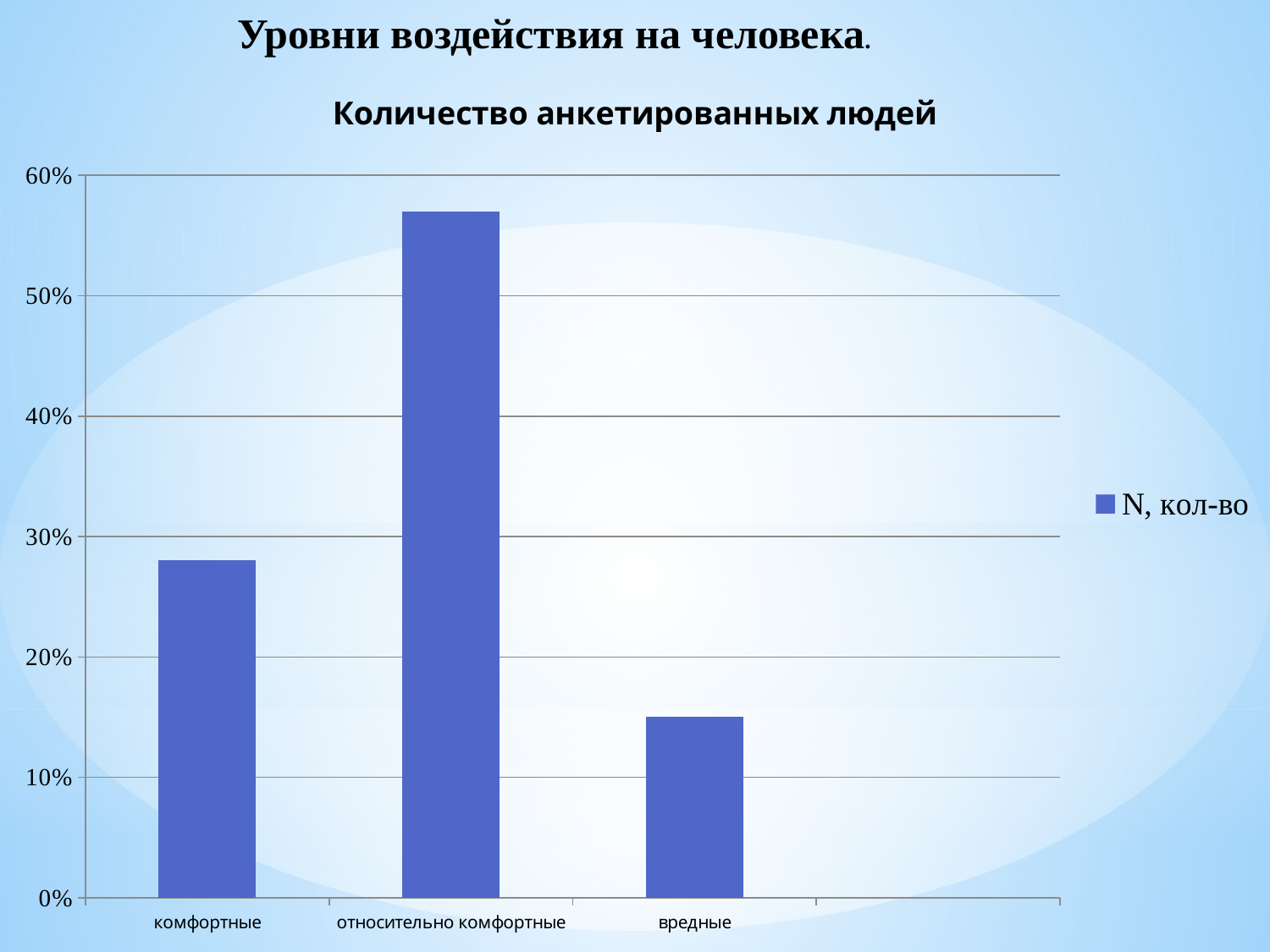
Is the value for комфортные greater or less than 30%? less Which category has the lowest bar? вредные Is the value for комфортные greater or less than 20%? greater Which is larger, the value for комфортные or the value for вредные? комфортные What is the title of the chart? Количество анкетированных людей Which is larger, the value for относительно комфортные or the value for комфортные? относительно комфортные How many categories are shown on the x axis of the chart? 3 Is the value for вредные greater or less than 10%? greater How many series does the legend list? 1 What kind of chart is shown on the slide? bar chart Which category has the highest bar? относительно комфортные